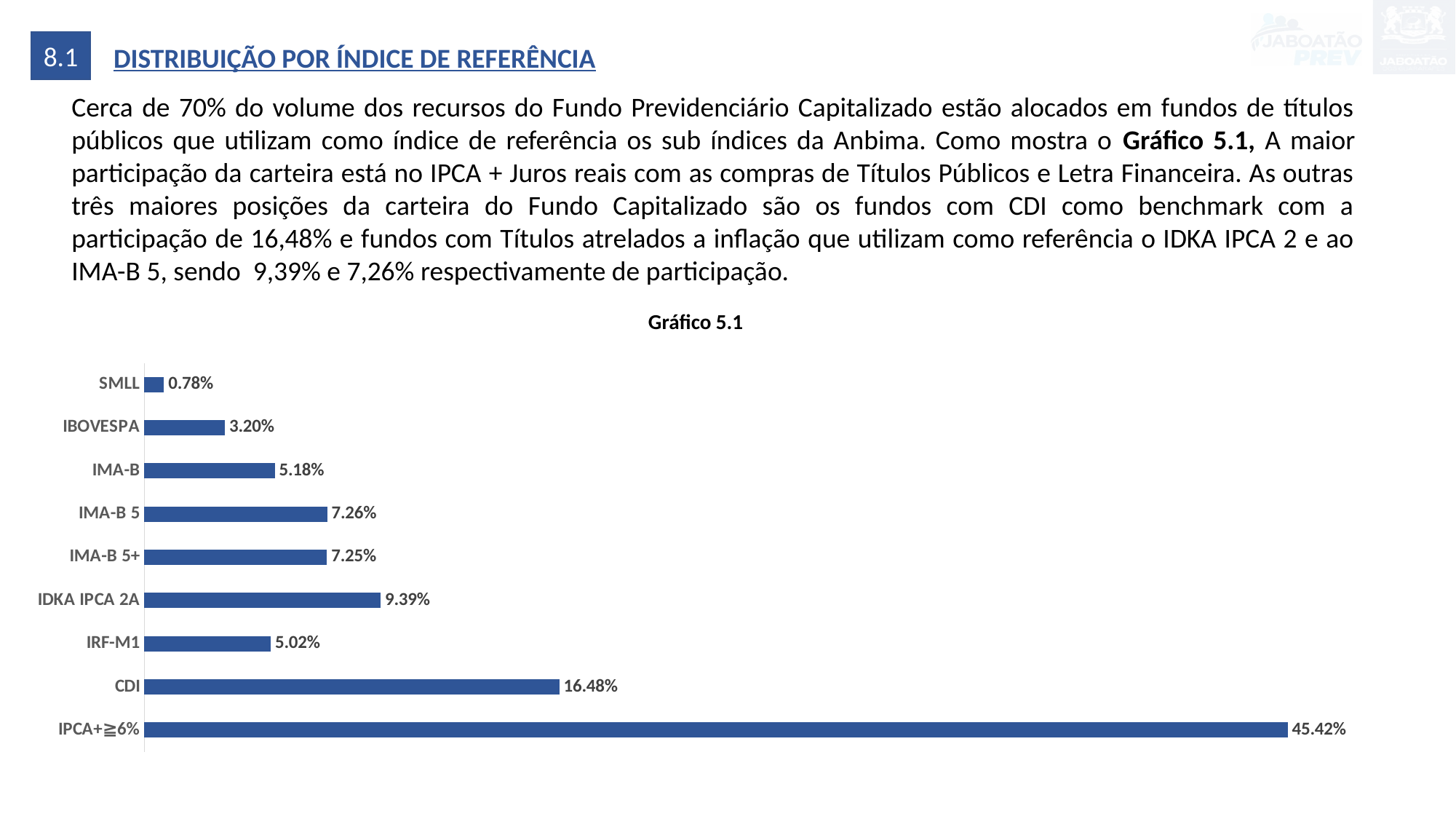
What is the value for CDI? 16.48% What is the value for IRF-M1? 5.02% What is the value for IBOVESPA? 3.20% What is the value for IDKA IPCA 2A? 9.39% Which category has the lowest value? SMLL How many categories are shown in the chart? 9 What is the difference between the values for CDI and IDKA IPCA 2A? 7.09% Which category has the highest value? IPCA+≧6% Which is larger, the value for IMA-B or the value for IRF-M1? IMA-B What kind of chart is shown on the slide? Bar chart What is the title of the chart? Gráfico 5.1 What is the difference between the values for IMA-B and IBOVESPA? 1.98%